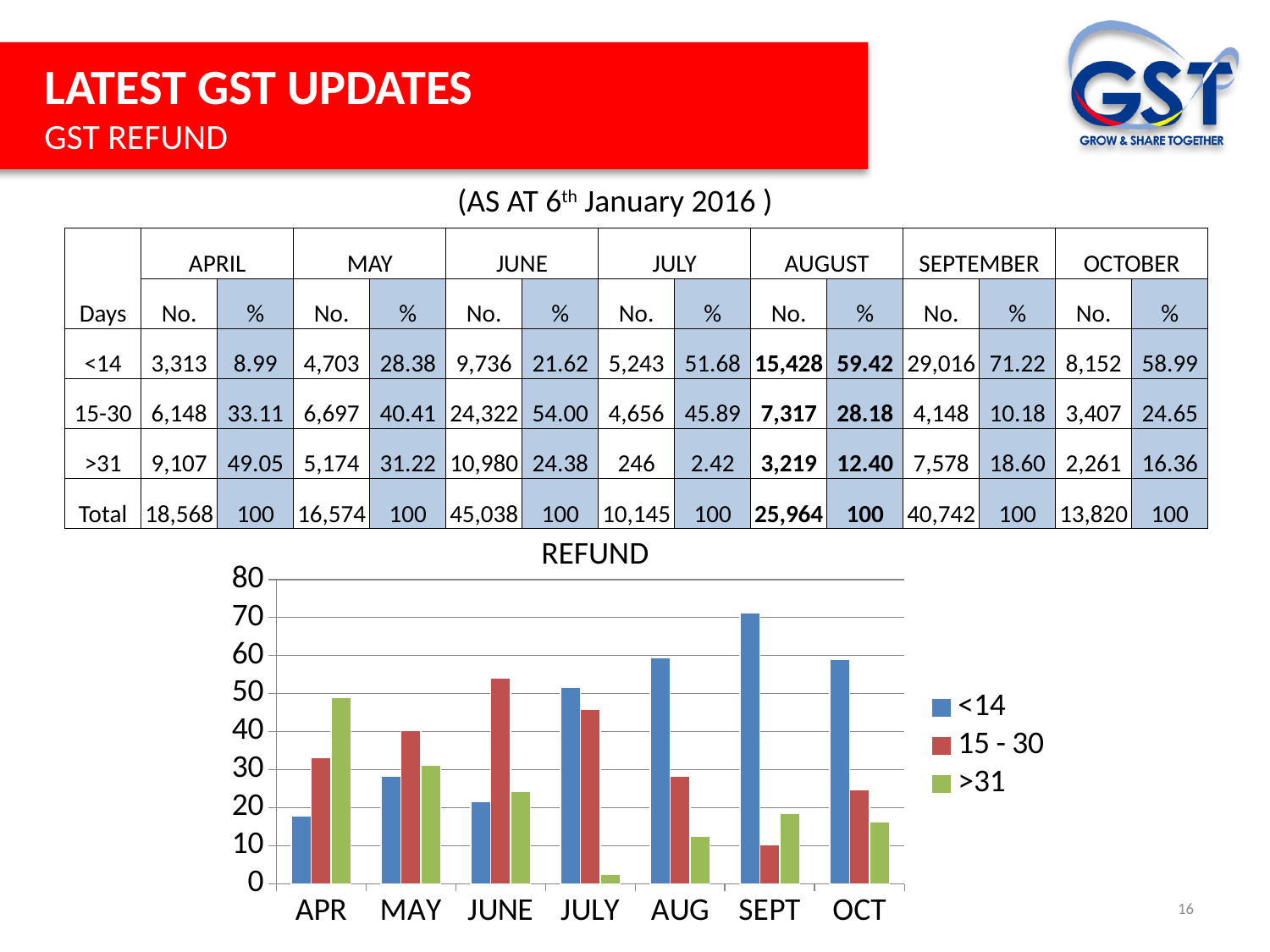
How many series does the legend of the REFUND chart list? 3 In the REFUND chart, does the <14 series rise or fall from JUNE to SEPT? rise How many months are shown on the x axis of the REFUND chart? 7 What type of chart is shown under the title REFUND? bar chart In the REFUND chart, which month has the lowest value for the 15 - 30 series? SEPT In the REFUND chart, which month has the highest value for the >31 series? APR In the REFUND chart, is the >31 value for JULY greater or less than 10? less In the REFUND chart, which month has the lowest value for the >31 series? JULY In the REFUND chart, which month has the highest value for the 15 - 30 series? JUNE In the REFUND chart, which month has the lowest value for the <14 series? APR In the REFUND chart, which month has the highest value for the <14 series? SEPT In the REFUND chart, is the <14 value for SEPT greater or less than 60? greater